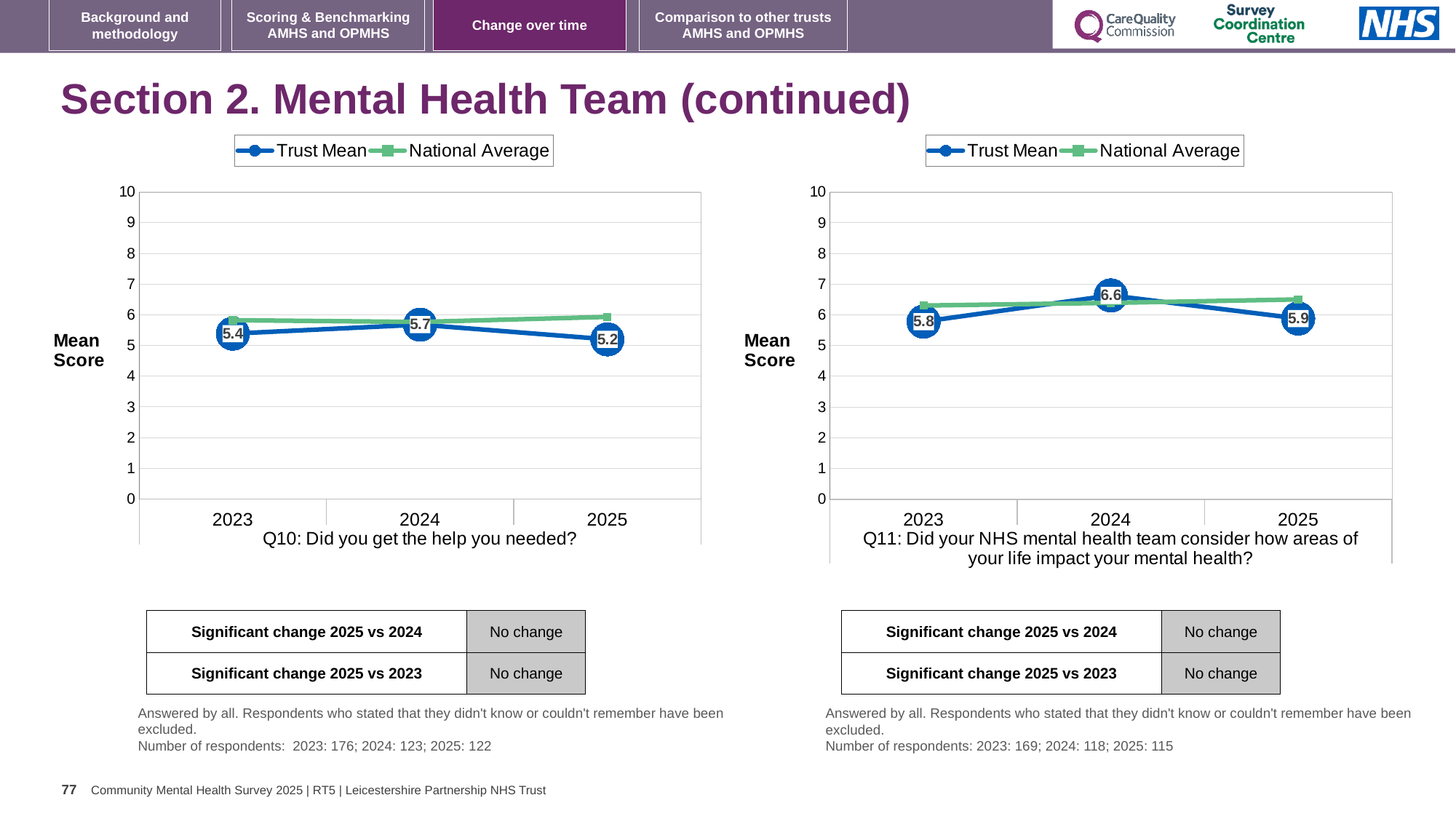
In the Q10 chart (left), what is the Trust Mean for 2024? 5.7 In the Q11 chart (right), what is the difference between the Trust Mean for 2024 and the Trust Mean for 2023? 0.8 How many series does the legend of the Q11 chart (right) list? 2 In the Q11 chart (right), which year has the highest Trust Mean? 2024 In the Q10 chart (left), which year has the lowest Trust Mean? 2025 In the Q11 chart (right), what is the Trust Mean for 2024? 6.6 In the Q10 chart (left), is the Trust Mean for 2023 or for 2024 larger? 2024 In the Q10 chart (left), does the Trust Mean rise or fall from 2024 to 2025? Fall In the Q11 chart (right), is the National Average for 2025 greater or less than 6? greater In the Q10 chart (left), what is the Trust Mean for 2025? 5.2 How many years are shown on the x axis of the Q10 chart (left)? 3 What kind of chart is the Q10 chart (left)? Line chart